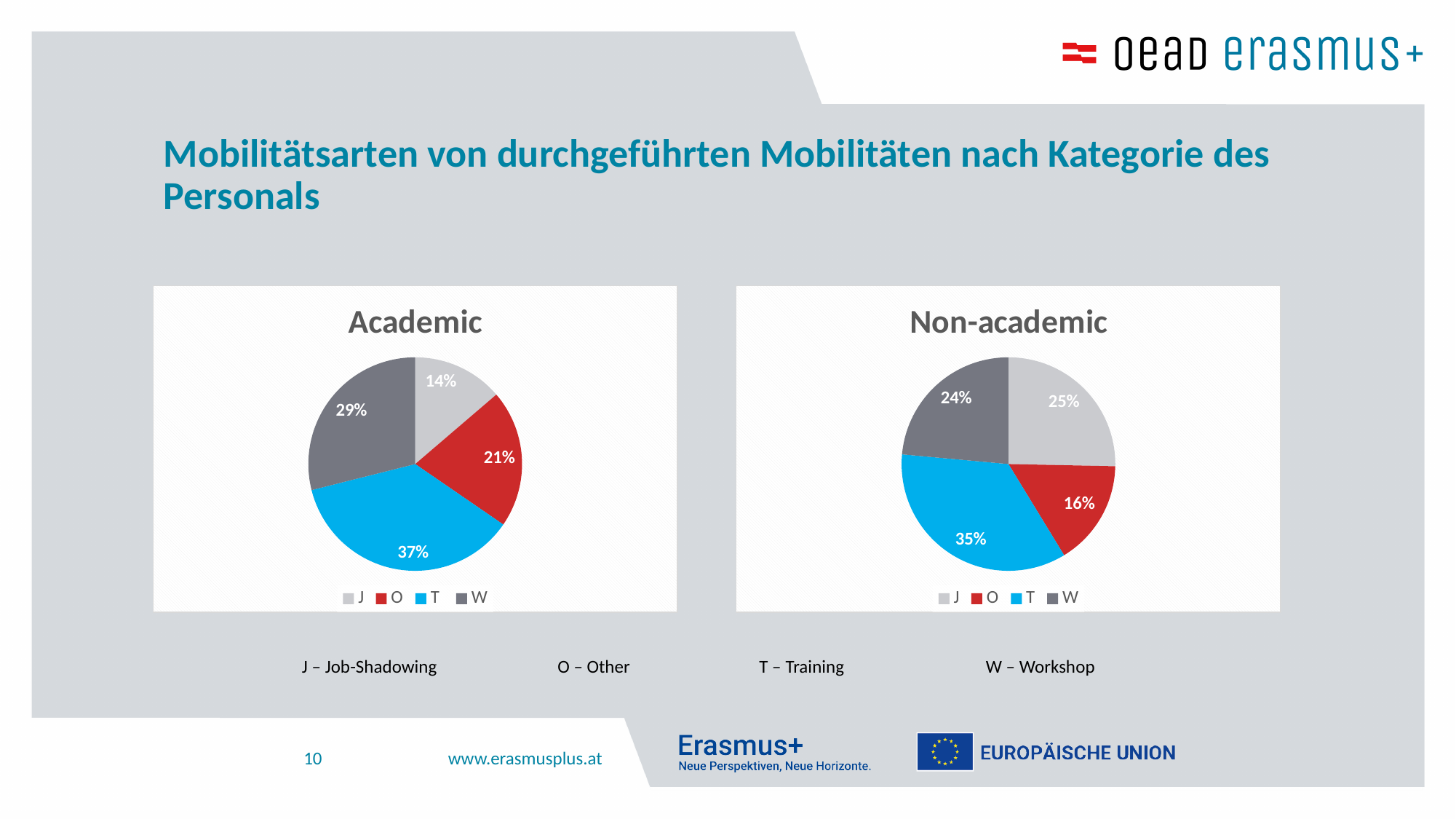
Is the share of W larger in the Academic chart or the Non-academic chart? Academic In the Non-academic pie chart, what share does J (Job-Shadowing) have? 25% In the Academic pie chart, what share does O (Other) have? 21% In the Non-academic pie chart, which category has the smallest share? O In the Academic pie chart, which category has the largest share? T Which colour represents T (Training) in the legends of both charts? Blue What type of chart is used for the Non-academic data? Pie chart In the Non-academic pie chart, what share does W (Workshop) have? 24% In the Academic pie chart, what share does T (Training) have? 37% In the Non-academic pie chart, what is the difference between the shares of T and O? 19% How many slices does the Academic pie chart have? 4 In the Academic pie chart, which category has the smallest share? J